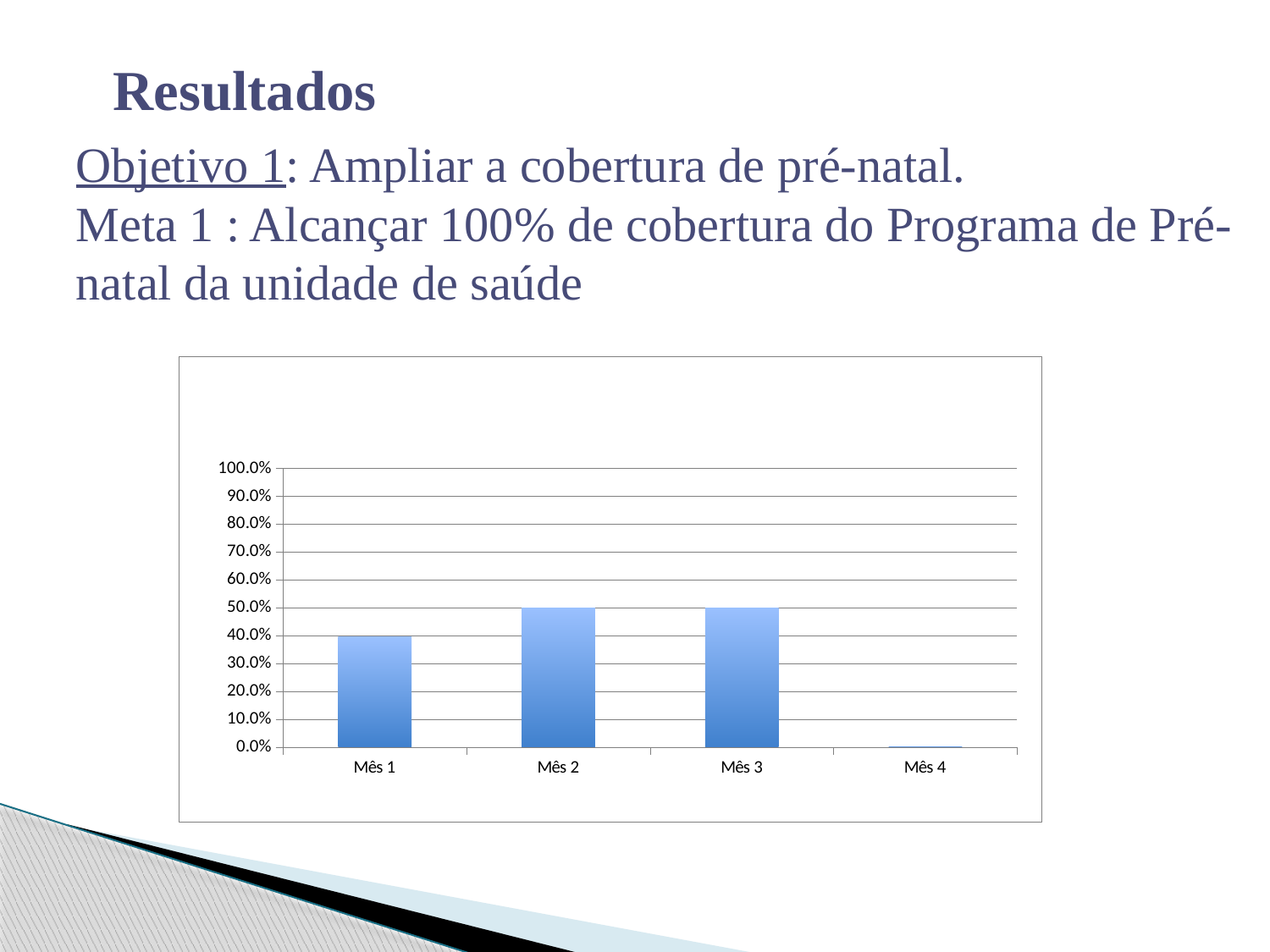
How many categories (months) are shown on the x axis of the chart? 4 What kind of chart is shown on the slide? bar chart Which is larger, the value for Mês 1 or the value for Mês 2? Mês 2 Which month has the lowest value? Mês 4 What is the value for Mês 2? 50.0% Is the value for Mês 4 greater or less than 10.0%? less What is the value for Mês 3? 50.0% Is the value for Mês 1 greater or less than 30.0%? greater Does the value rise or fall from Mês 1 to Mês 2? rise What is the highest value shown on the y axis of the chart? 100.0%